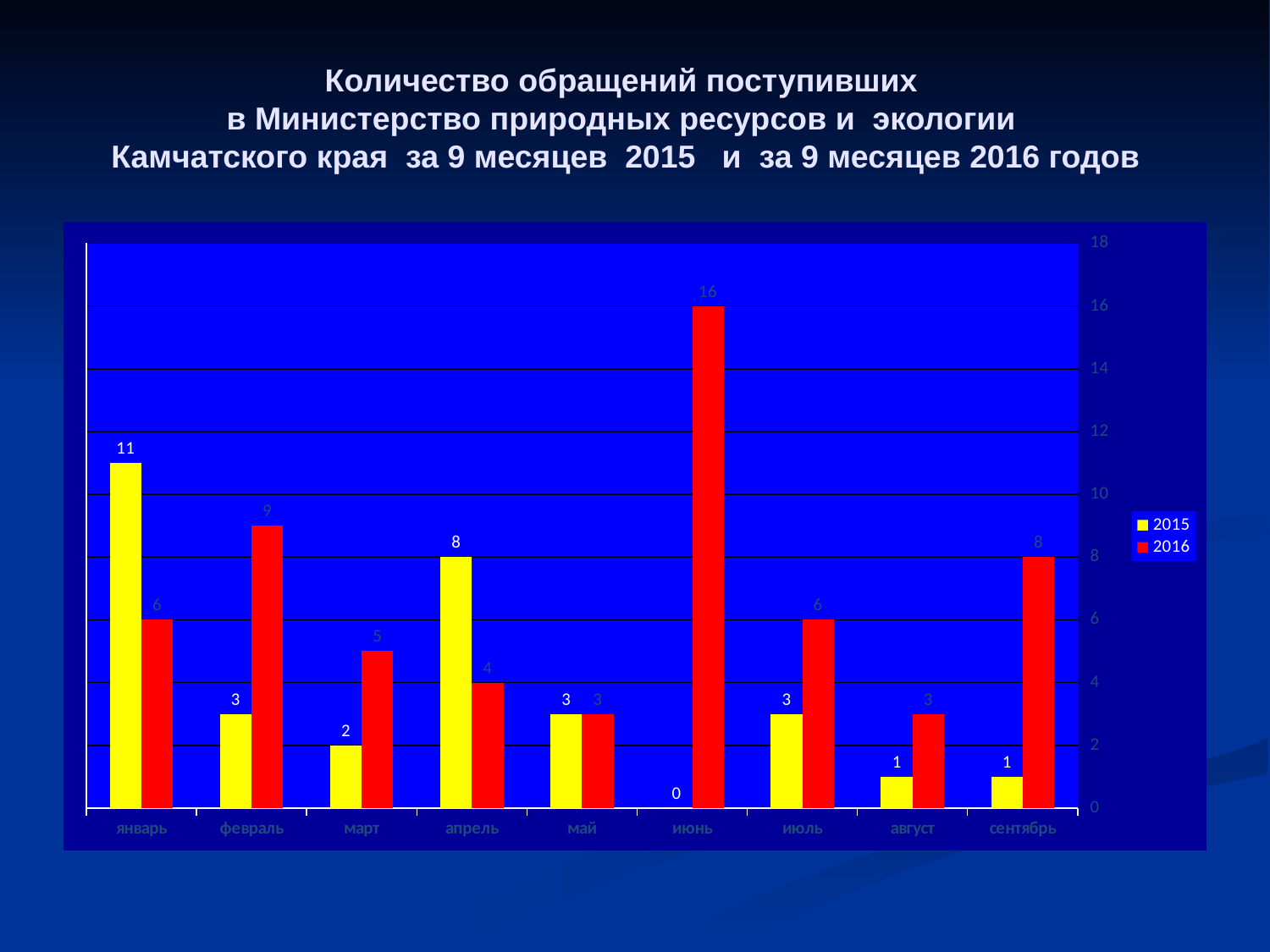
How many months are shown on the x axis? 9 Which is larger in апрель, the 2015 value or the 2016 value? 2015 What is the value for 2016 in сентябрь? 8 What is the value for 2015 in январь? 11 What is the difference between the 2016 and 2015 values in июнь? 16 What is the value for 2016 in июнь? 16 How many series does the legend list? 2 What is the difference between the 2015 and 2016 values in январь? 5 What kind of chart is shown on the slide? bar chart Which month has the highest value for the 2016 series? июнь Which month has the lowest value for the 2015 series? июнь Which colour represents the 2016 series in the legend? red